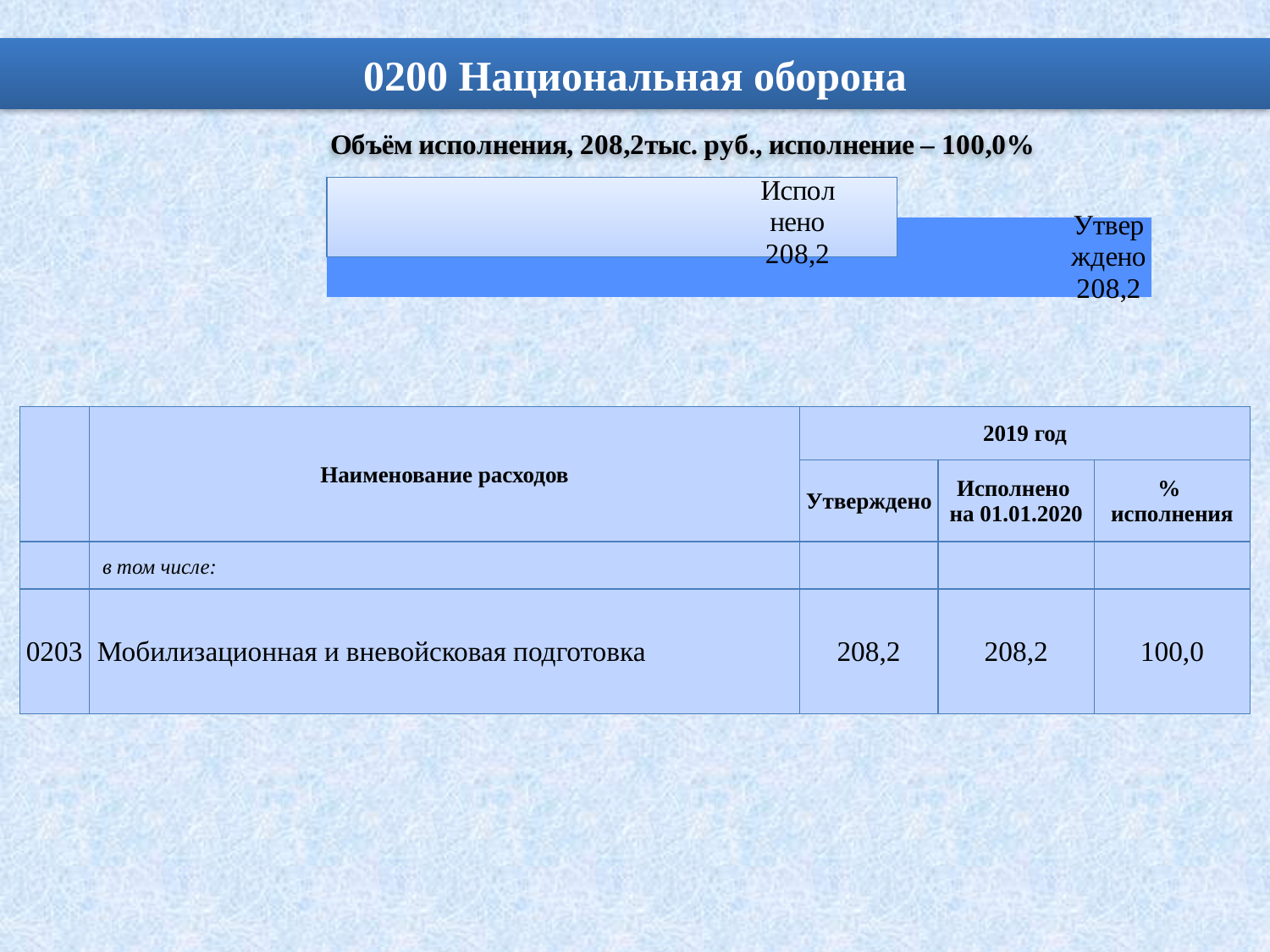
What is the value of the bar labelled "Утверждено" in the chart? 208,2 What is the difference between the "Утверждено" and "Исполнено" values in the chart? 0,0 Is the value for "Утверждено" in the chart greater or less than 300? less Is the value for "Исполнено" in the chart greater or less than 100? greater What kind of chart is shown on the slide? bar chart What is the title shown at the top of the slide above the chart? 0200 Национальная оборона What is the value of the bar labelled "Исполнено" in the chart? 208,2 How many bars are plotted in the chart? 2 Are the bars in the chart drawn horizontally or vertically? horizontally